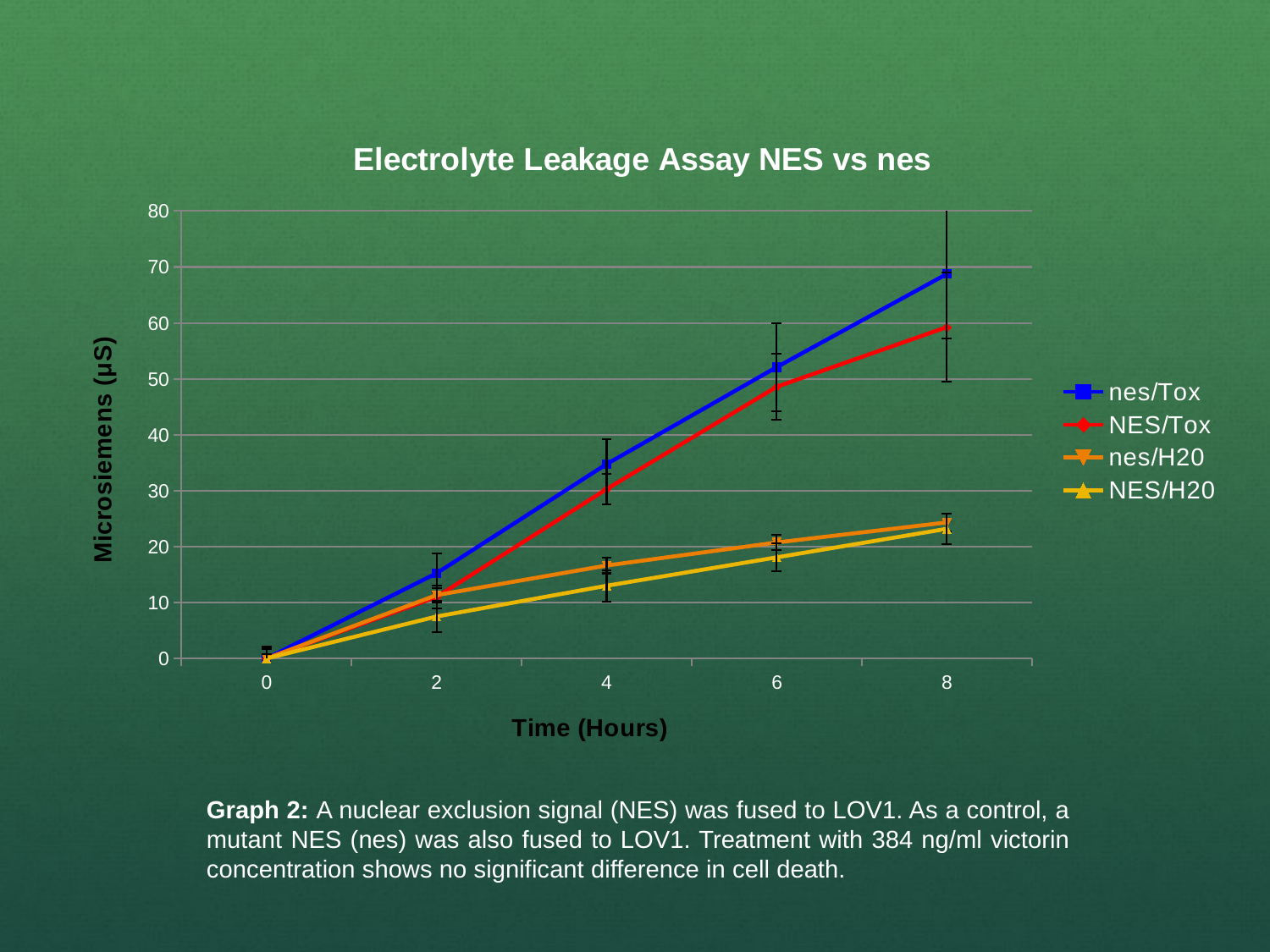
At 6 hours, which is larger: nes/Tox or NES/H20? nes/Tox What kind of chart is shown on the slide? line chart What is the title of the chart? Electrolyte Leakage Assay NES vs nes Is the value for nes/Tox at 4 hours greater or less than 30? greater Does the nes/Tox series rise or fall as time increases from 0 to 8 hours? rise Is the value for NES/H20 at 4 hours greater or less than 20? less Is the value for NES/Tox at 8 hours greater or less than 50? greater How many time points are plotted along the x axis? 5 Which series has the highest value at 8 hours? nes/Tox How many series does the legend list? 4